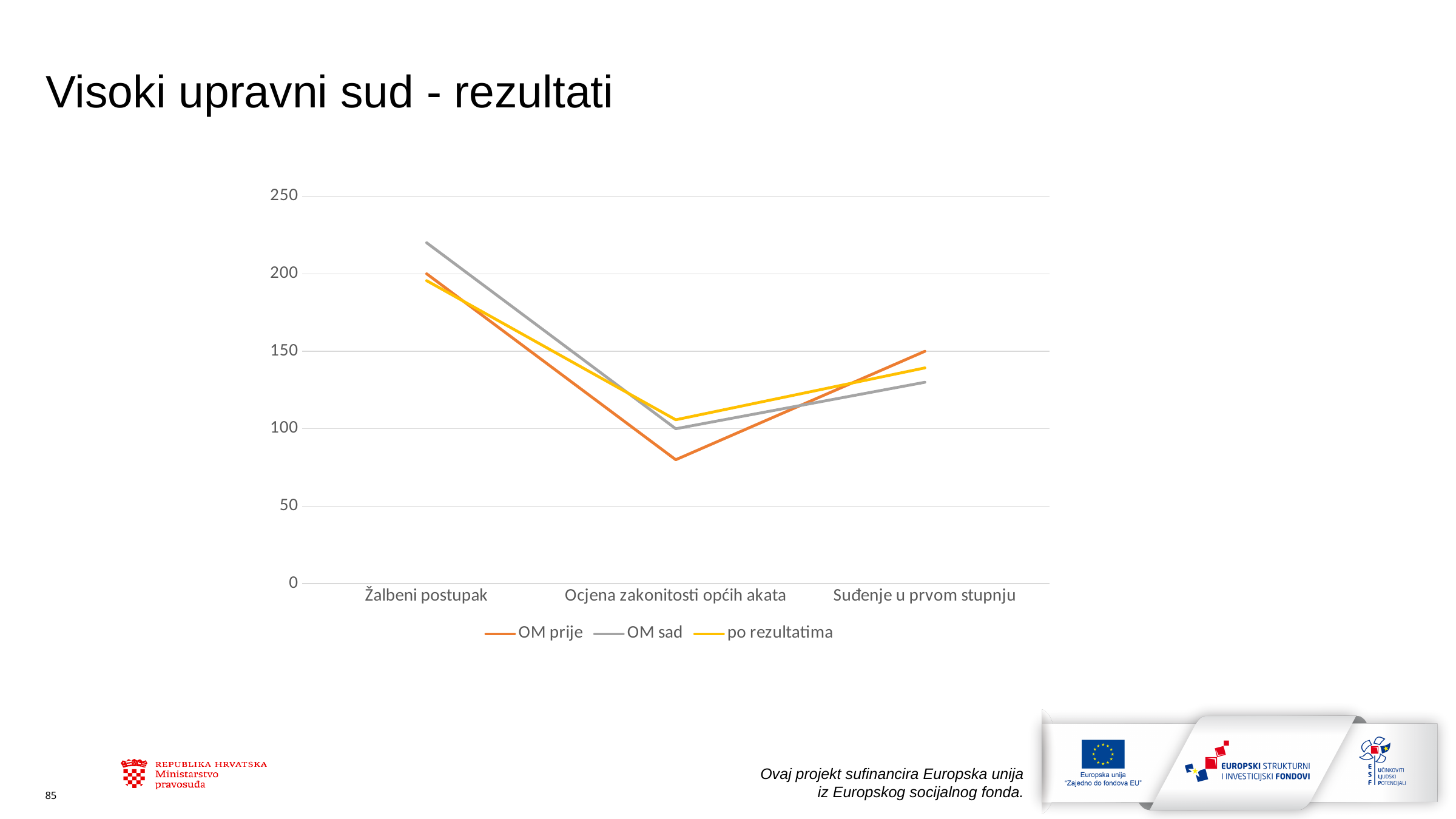
What kind of chart is shown on the slide? line chart Is the value for OM prije at Ocjena zakonitosti općih akata greater or less than 100? less Is the value for po rezultatima at Suđenje u prvom stupnju greater or less than 150? less How many categories are shown on the x axis? 3 For which category is the OM sad value lowest? Ocjena zakonitosti općih akata At Žalbeni postupak, which series has the larger value: OM prije or OM sad? OM sad Does the OM prije line rise or fall from Ocjena zakonitosti općih akata to Suđenje u prvom stupnju? rise For which category is the OM prije value highest? Žalbeni postupak What are the three series names listed in the legend? OM prije, OM sad, po rezultatima At Suđenje u prvom stupnju, which series has the larger value: OM prije or OM sad? OM prije Is the value for OM sad at Žalbeni postupak greater or less than 200? greater How many series does the legend list? 3